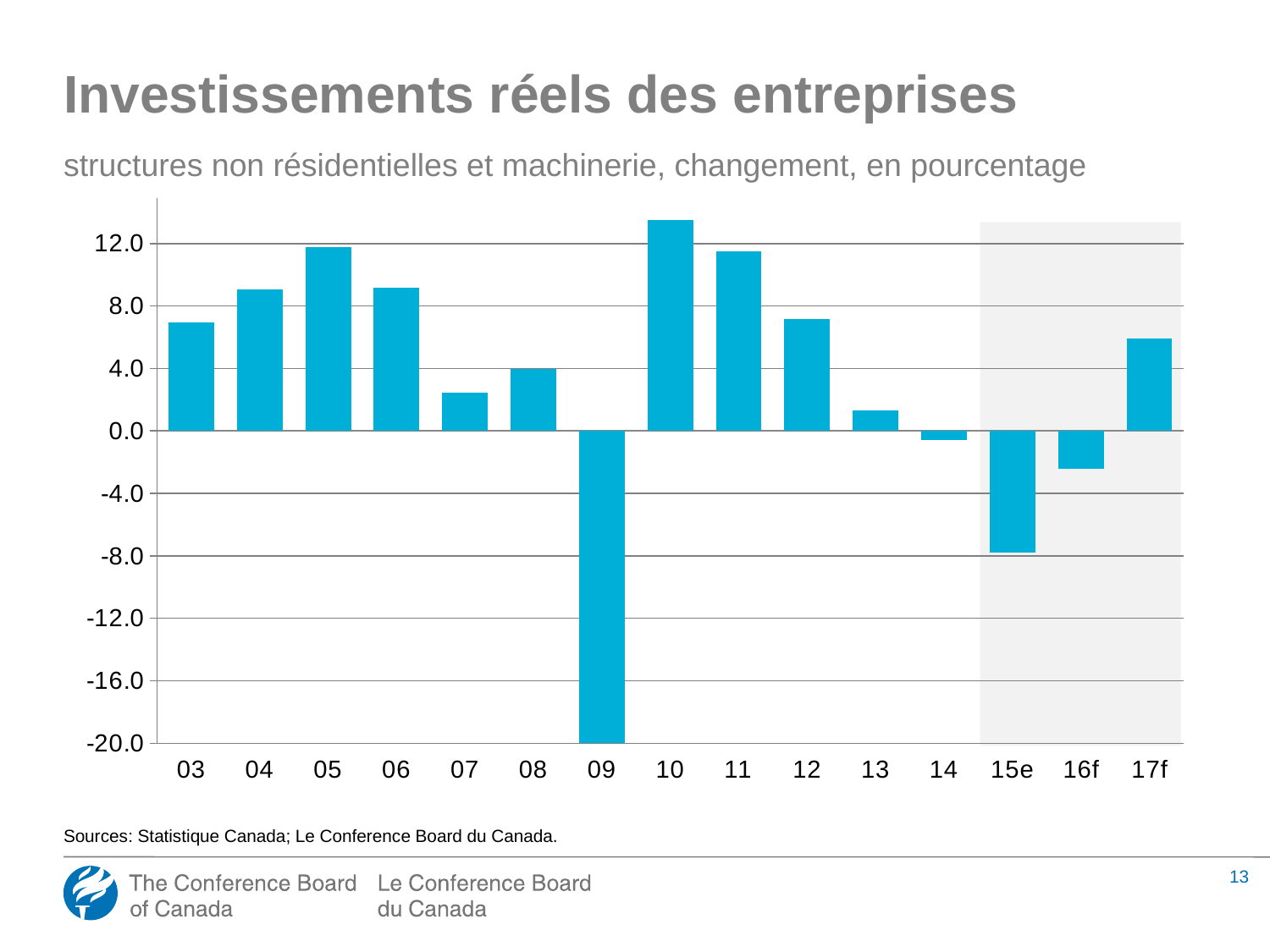
Which year has the lowest value? 09 Do the values rise or fall from 10 to 14? fall Is the value for 17f greater or less than 4.0? greater Is the value for 07 greater or less than 4.0? less What is the title of the chart? Investissements réels des entreprises Is the value for 09 greater or less than -12.0? less Which year has the highest value? 10 Which is larger, the value for 04 or the value for 13? 04 What kind of chart is shown on the slide? bar chart How many years (categories) are shown on the x axis? 15